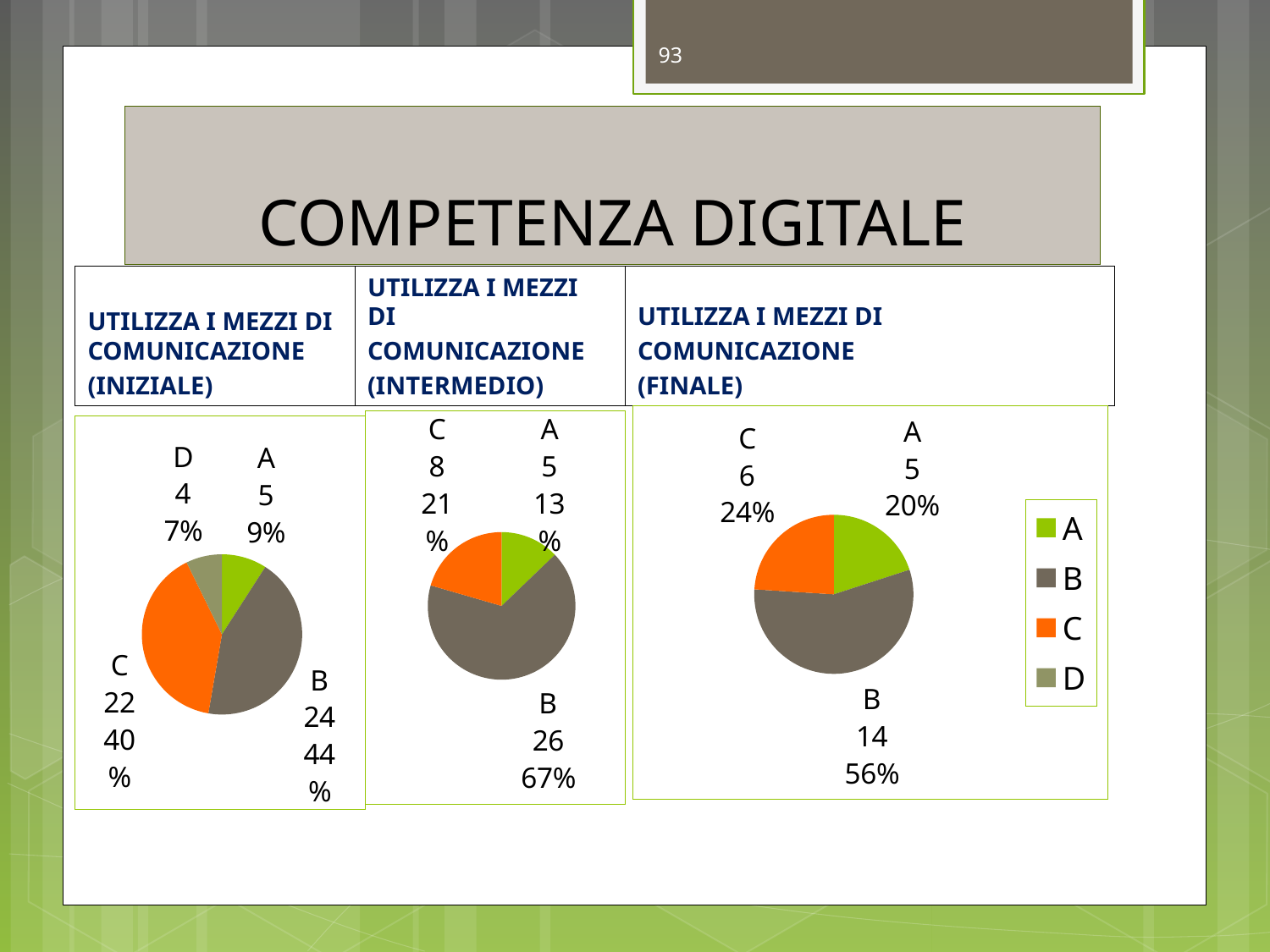
In the FINALE pie chart, which category has the largest slice? B What kind of chart is used for the INIZIALE data? Pie chart In the INIZIALE pie chart, what percentage is shown for category C? 40% In the INIZIALE pie chart, which category has the smallest slice? D In the INTERMEDIO pie chart, what percentage is shown for category B? 67% How many slices does the INTERMEDIO pie chart have? 3 How many entries does the legend on the right of the slide list? 4 In the FINALE pie chart, what share of the pie does category A represent? 20% In the FINALE pie chart, what value is shown for category C? 6 In the INIZIALE pie chart, what value is shown for category B? 24 In the INTERMEDIO pie chart, what is the difference between the values for B and C? 18 In the FINALE pie chart, which is larger, the value for A or the value for C? C